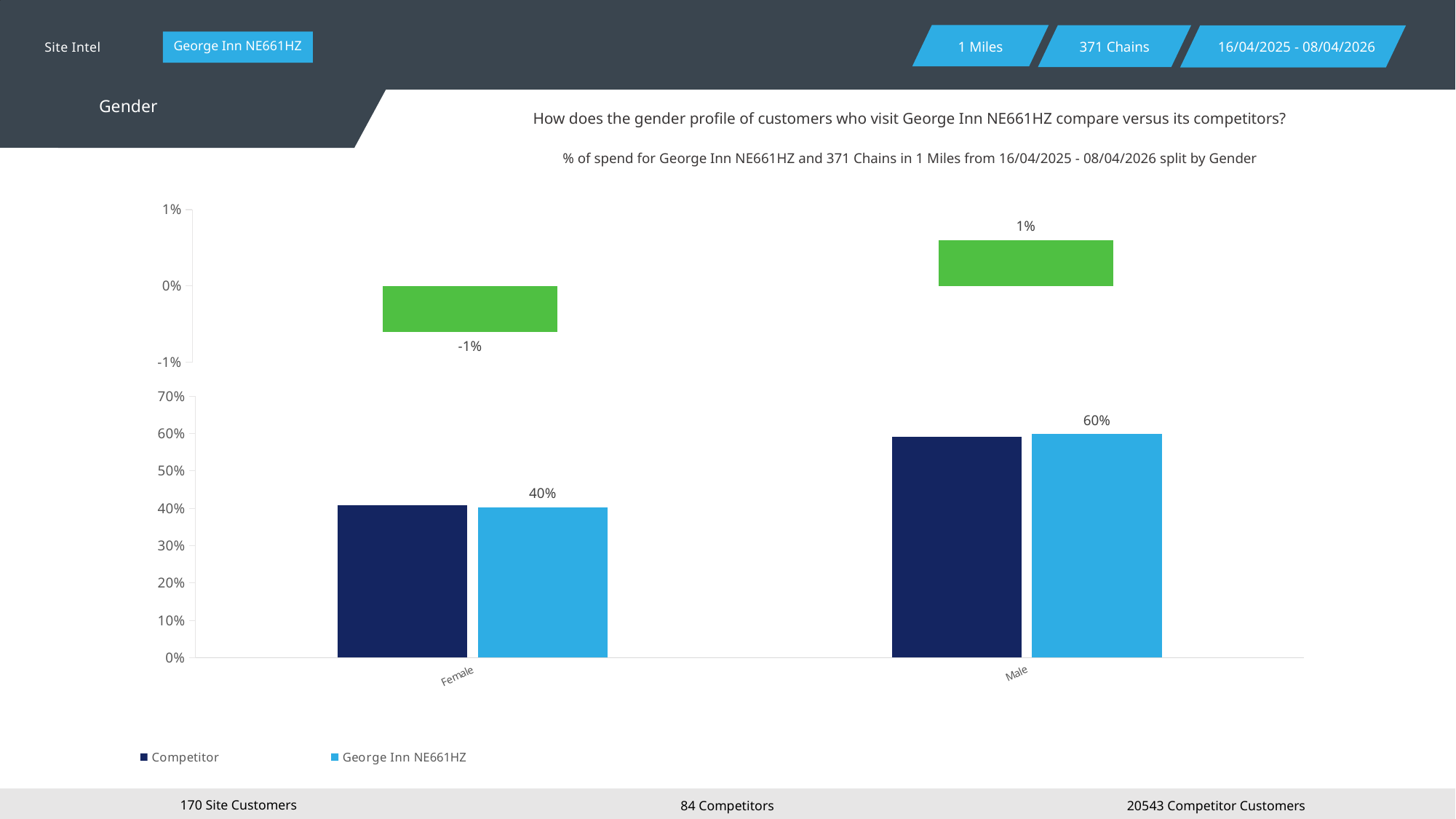
In the top chart, what is the value shown for Female? -1% In the bottom chart, which gender category has the higher value for George Inn NE661HZ? Male How many series does the legend of the bottom chart list? 2 In the bottom chart, which series is shown in dark navy blue? Competitor In the bottom chart, what is the difference between the George Inn NE661HZ values for Male and Female? 20% In the bottom chart, is the Competitor value for Female greater or less than 50%? less In the bottom chart, what is the value for George Inn NE661HZ for Male? 60% In the bottom chart, is the Competitor value for Male greater or less than 50%? greater In the bottom chart, what is the value for George Inn NE661HZ for Female? 40% In the top chart, what is the value shown for Male? 1% What type of chart is the bottom chart? Bar chart How many gender categories are shown on the x axis of the bottom chart? 2